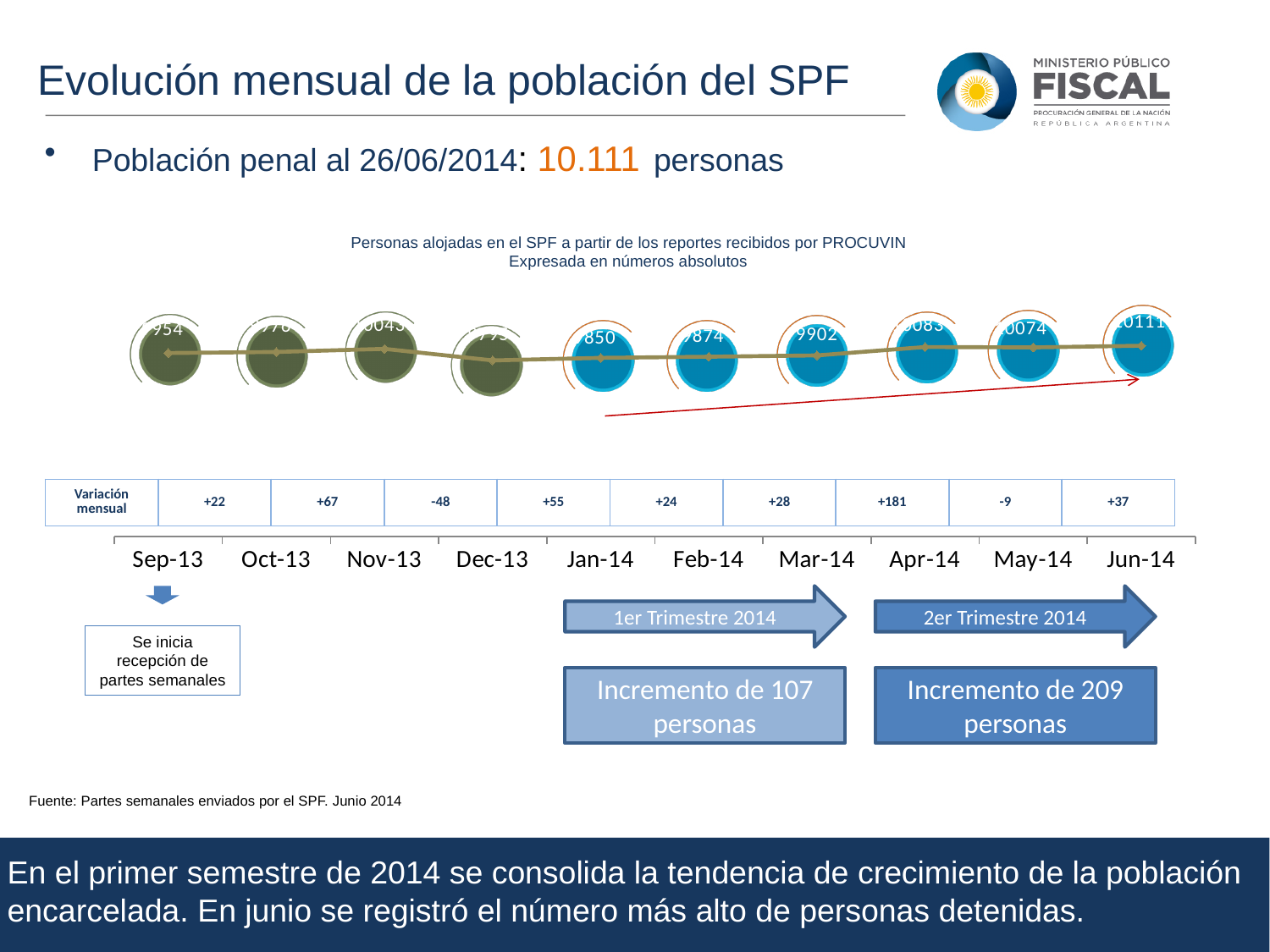
What is the value plotted for Feb-14? 9874 What is the difference between the values for Jun-14 and Mar-14? 209 What is the value plotted for Jun-14? 10111 What is the value plotted for Mar-14? 9902 What is the title of the chart? Personas alojadas en el SPF a partir de los reportes recibidos por PROCUVIN Expresada en números absolutos In the 'Variación mensual' row, what is the monthly variation shown for Apr-14? +181 Do the plotted values generally rise or fall from Sep-13 to Jun-14? Rise What type of chart is used to show the monthly SPF population? Line chart How many months are plotted on the chart? 10 What is the difference between the values for Mar-14 and Feb-14? 28 Which month has the highest plotted value? Jun-14 Which is larger, the value for Jun-14 or the value for Mar-14? Jun-14